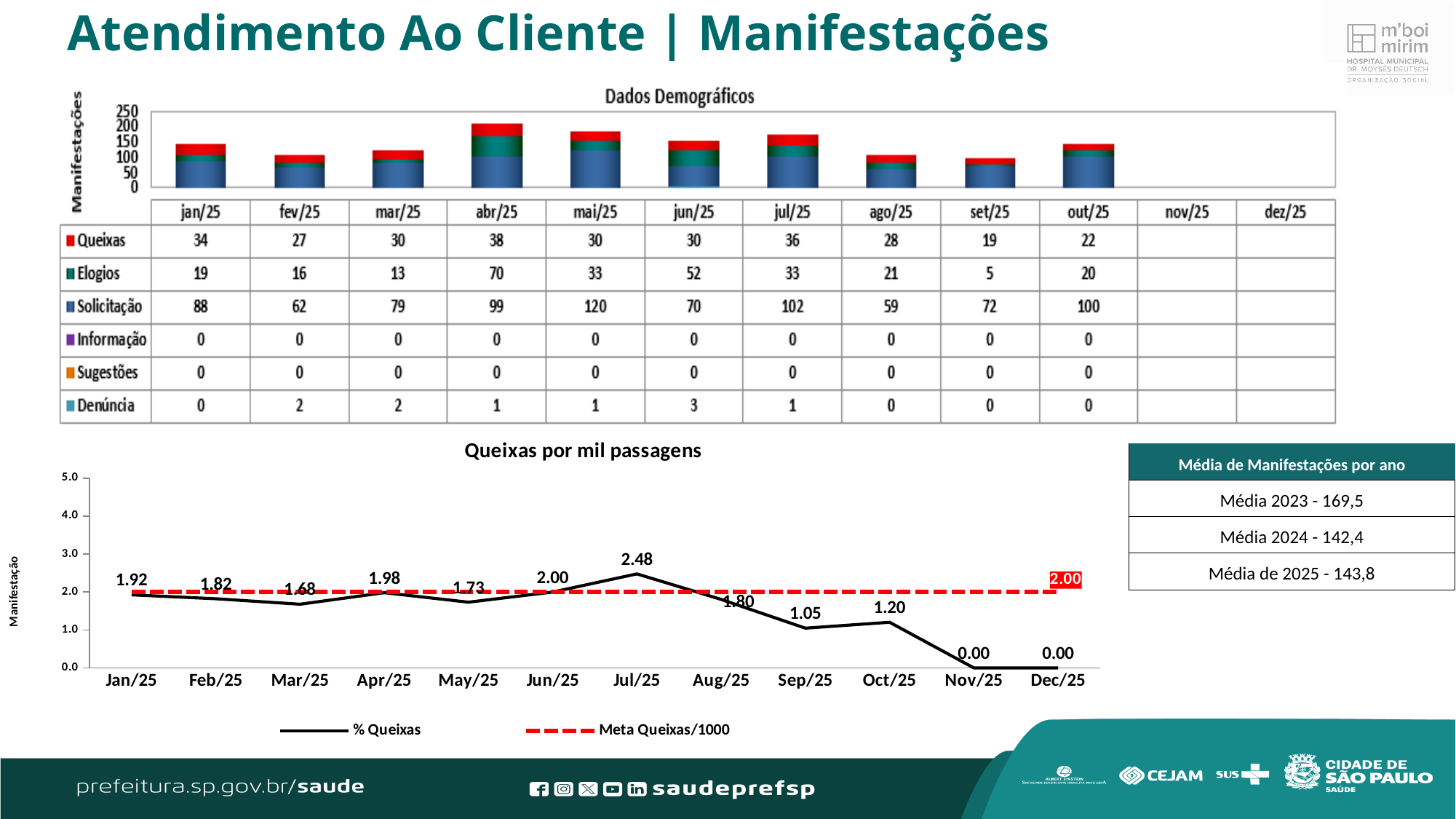
In the 'Dados Demográficos' chart, what is the value of Solicitação for mai/25? 120 In the 'Queixas por mil passagens' chart, how many series does the legend list? 2 In the 'Dados Demográficos' chart, how many series are listed in the table legend? 6 In the 'Dados Demográficos' chart, what is the difference between Queixas in jan/25 and Queixas in set/25? 15 In the 'Dados Demográficos' chart, what is the total of the stacked bar for abr/25? 208 In the 'Dados Demográficos' chart, which month has the lowest value for Elogios? set/25 What kind of chart is 'Dados Demográficos'? Stacked bar chart In the 'Dados Demográficos' chart, what is the value of Queixas for abr/25? 38 In the 'Queixas por mil passagens' chart, is the % Queixas value for Sep/25 greater or less than the Meta Queixas/1000 value of 2.00? less In the 'Queixas por mil passagens' chart, what is the % Queixas value for Jul/25? 2.48 In the 'Dados Demográficos' chart, which month has the highest value for Solicitação? mai/25 In the 'Queixas por mil passagens' chart, which month has the highest % Queixas value? Jul/25